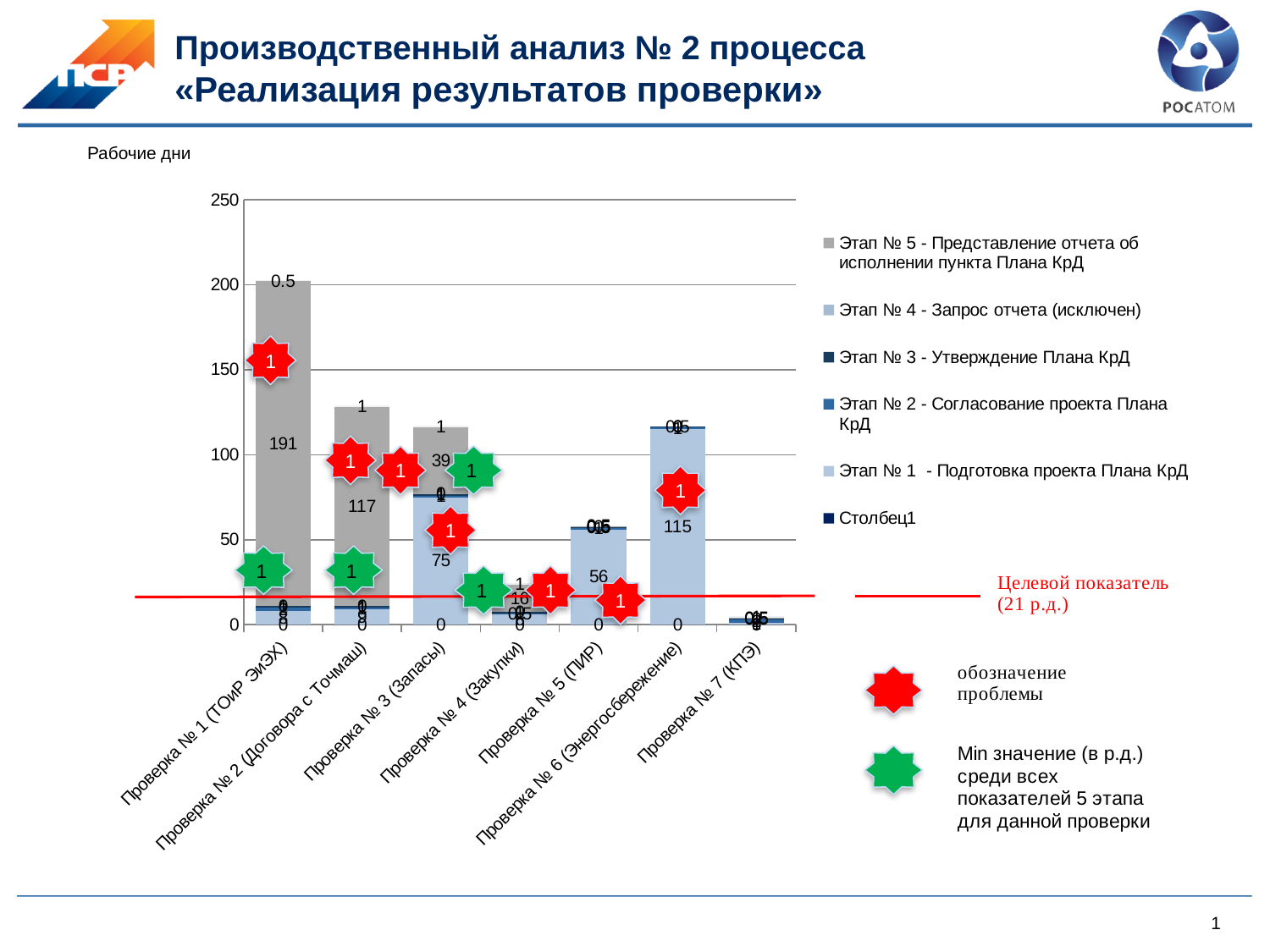
How many checks (Проверка) are shown along the x axis of the chart? 7 What is the value of the Этап № 5 segment for Проверка № 2 (Договора с Точмаш)? 117 Which check has the tallest stacked bar overall? Проверка № 1 (ТОиР ЭиЭХ) Which check has the shortest stacked bar overall? Проверка № 7 (КПЭ) What is the value of the Этап № 5 segment for Проверка № 1 (ТОиР ЭиЭХ)? 191 Is the total height of the bar for Проверка № 6 (Энергосбережение) greater or less than 100? greater What type of chart is shown on the slide? Stacked bar chart What is the difference between the Этап № 5 values for Проверка № 1 (191) and Проверка № 2 (117)? 74 What target value (Целевой показатель) is marked by the red horizontal line? 21 р.д. What is the largest data label shown on the bar for Проверка № 5 (ПИР)? 56 What is the largest data label shown on the bar for Проверка № 6 (Энергосбережение)? 115 How many series does the chart legend list? 6